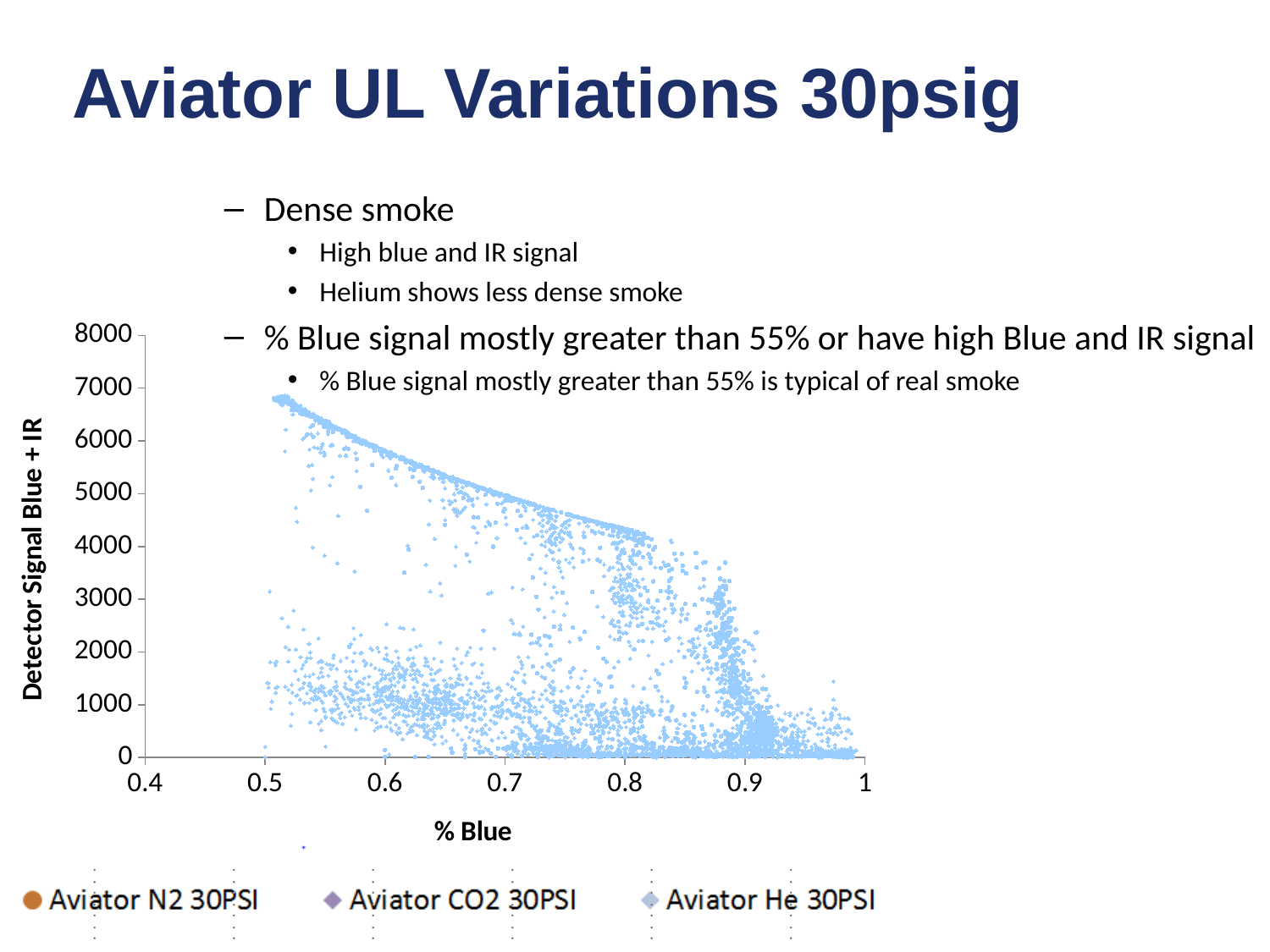
What kind of chart is shown on the slide? scatter chart What is the title of the y axis of the chart? Detector Signal Blue + IR What is the title of the x axis of the chart? % Blue Is the highest Detector Signal Blue + IR value plotted on the chart greater or less than 7000? less Is the lowest % Blue value at which points are plotted greater or less than 0.4? greater What is the maximum value shown on the y axis of the chart? 8000 Does the upper edge of the plotted points rise or fall as % Blue increases from 0.5 to 0.8? fall How many series does the chart legend list? 3 Is the highest Detector Signal Blue + IR value plotted on the chart greater or less than 6000? greater